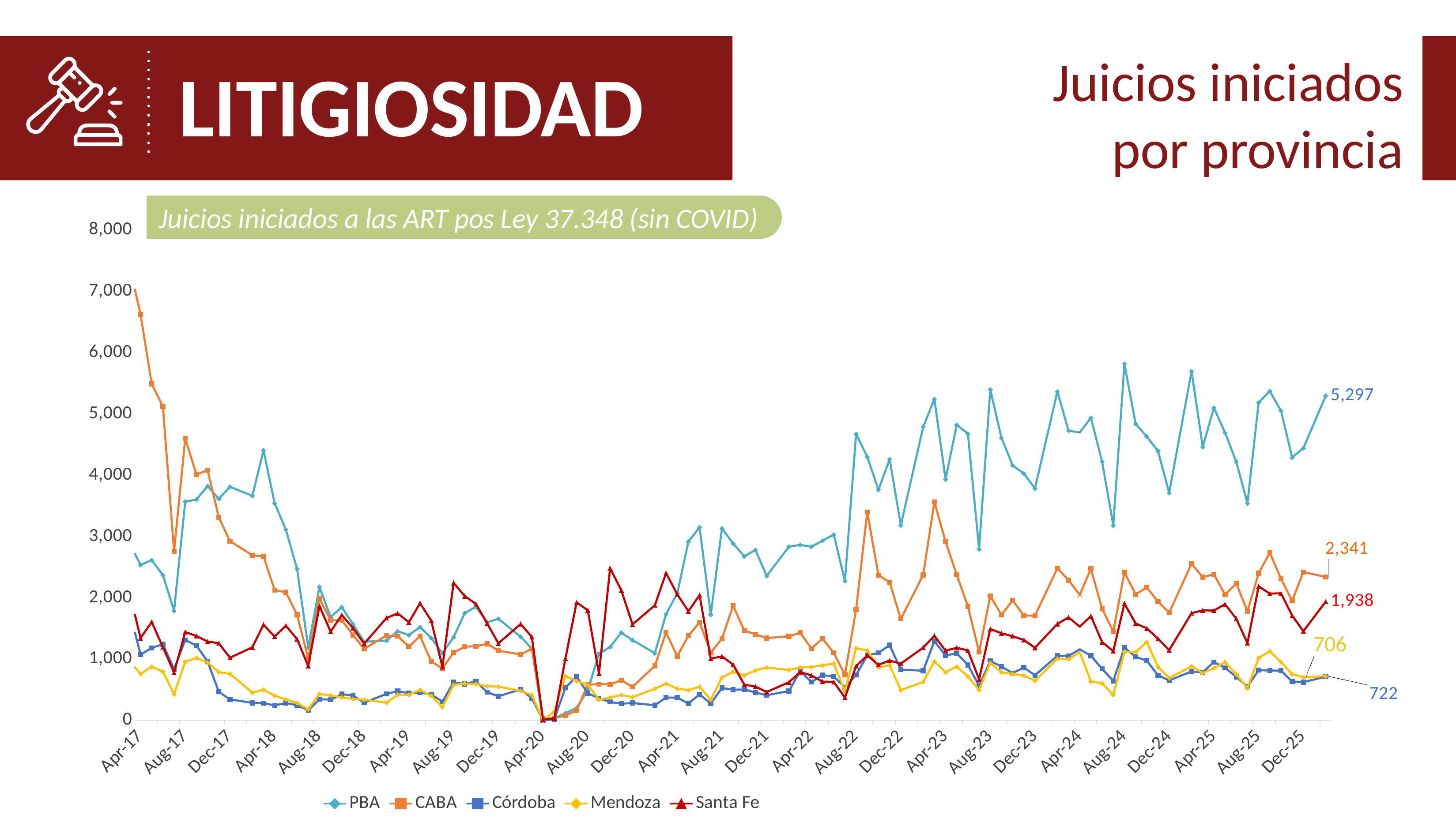
Which series has the highest value at the end of the chart? PBA Which series has the lowest labelled value at the end of the chart? Mendoza What is the last labelled value for the Mendoza series? 706 What is the last labelled value for the Santa Fe series? 1,938 How many series does the legend list? 5 At the end of the chart, which is larger: the Córdoba value or the Mendoza value? Córdoba What is the difference between the final labelled values of PBA and CABA? 2,956 What is the last labelled value for the CABA series? 2,341 What is the title of the chart? Juicios iniciados a las ART pos Ley 37.348 (sin COVID) Is the CABA value at Apr-17 greater or less than 6,000? greater What kind of chart is shown on the slide? line chart What is the last labelled value for the PBA series? 5,297